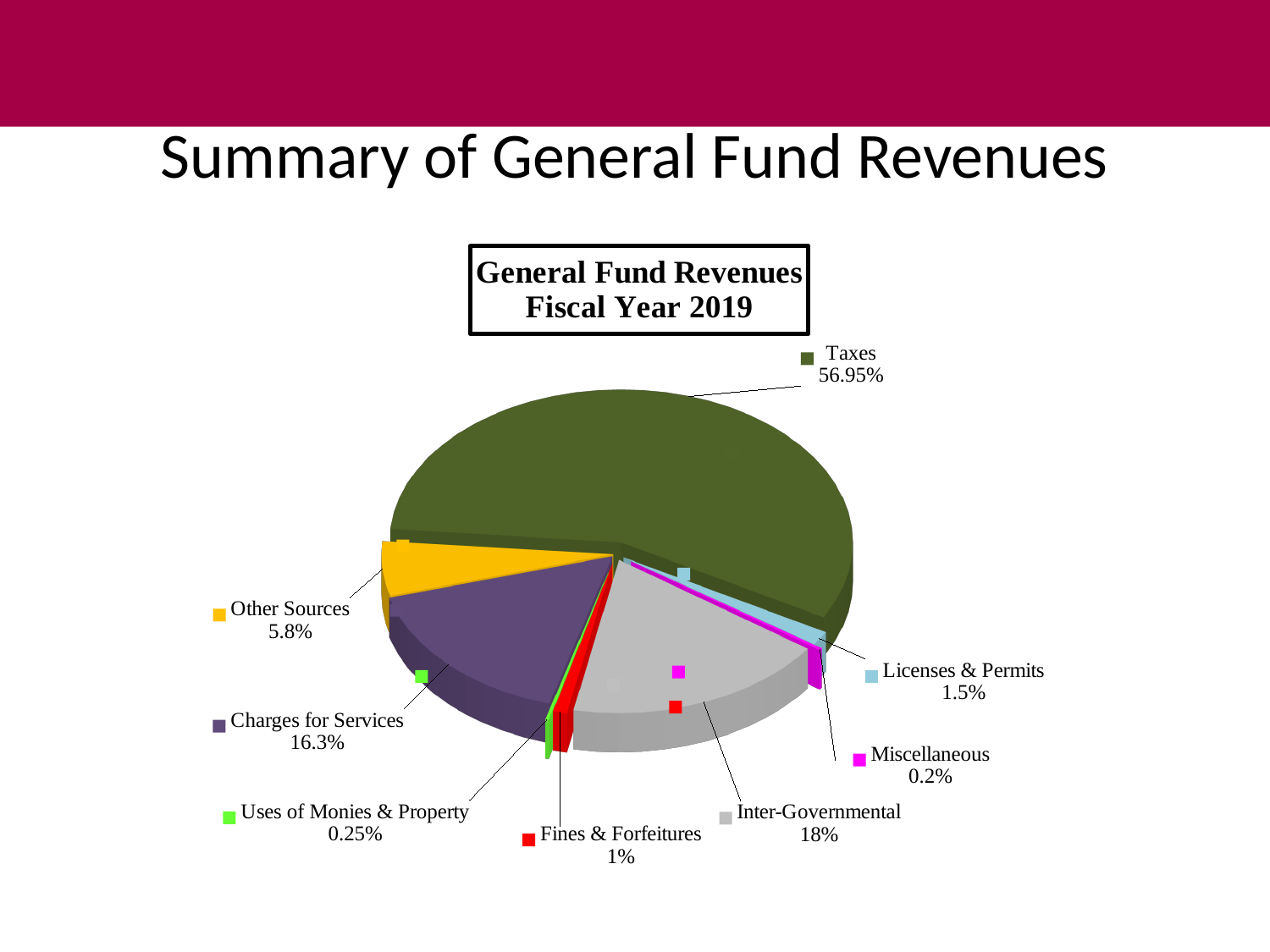
How many categories are shown in the pie chart? 8 Which category has the largest share of the pie? Taxes What colour is the Taxes slice? Dark green What is the difference in percentage points between Inter-Governmental and Charges for Services? 1.7 Which category has the smallest share of the pie? Miscellaneous What percentage is shown for Uses of Monies & Property? 0.25% What is the title of the chart? General Fund Revenues Fiscal Year 2019 What share of General Fund Revenues comes from Taxes? 56.95% Which is larger, Other Sources or Licenses & Permits? Other Sources What kind of chart is shown on the slide? Pie chart What percentage is shown for Charges for Services? 16.3% What percentage is shown for Inter-Governmental? 18%